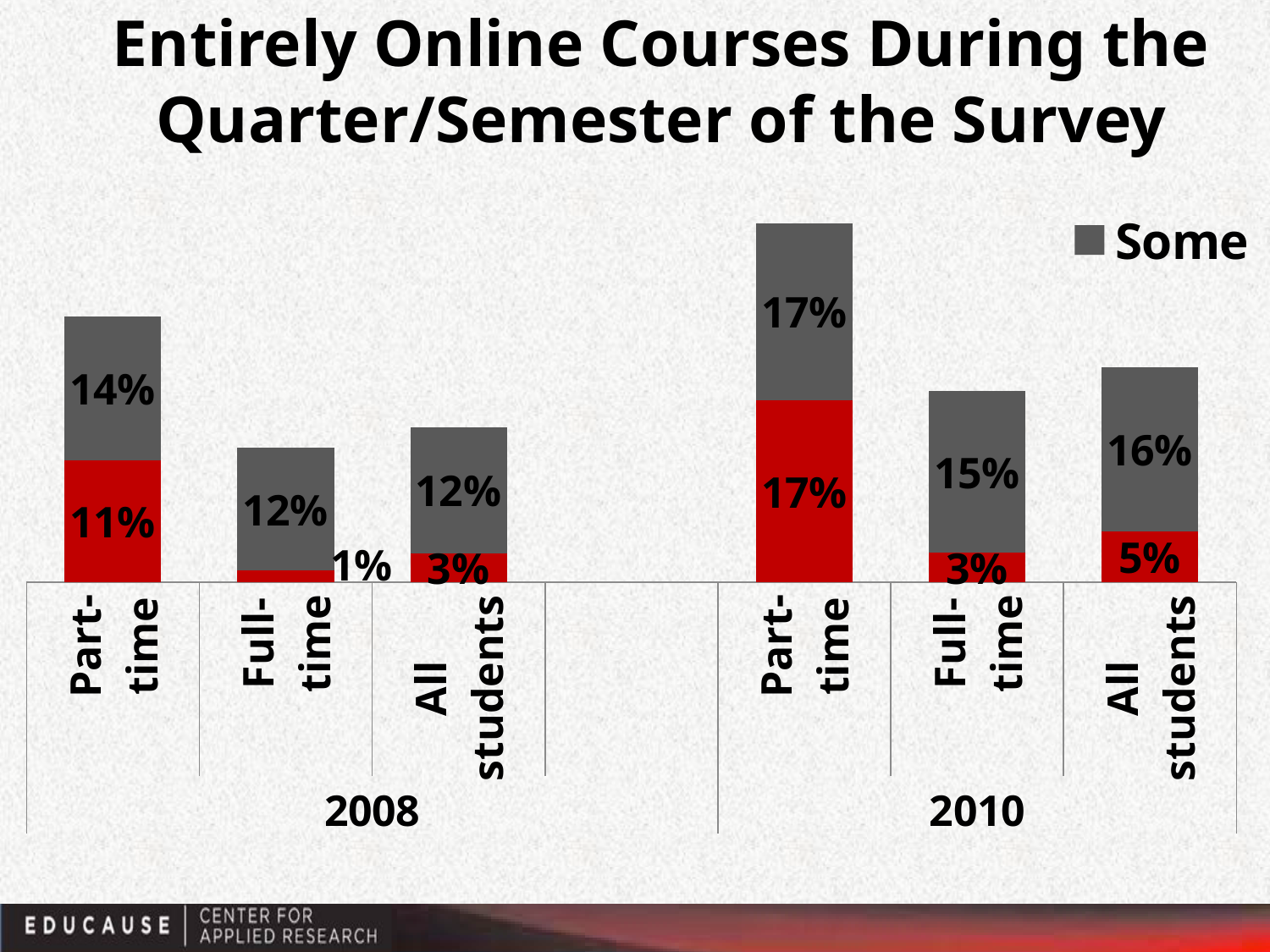
Is the red (lower) segment larger for Part-time students in 2008 or for Part-time students in 2010? 2010 What is the value of the "Some" segment for Full-time students in 2010? 15% What is the value of the "Some" segment for Part-time students in 2008? 14% What is the value of the red (lower) segment for All students in 2008? 3% What is the value of the red (lower) segment for Full-time students in 2008? 1% What is the total height of the stacked bar for All students in 2008? 15% What type of chart is shown on the slide? Stacked bar chart What is the value of the red (lower) segment for Part-time students in 2010? 17% Which stacked bar is the tallest overall? Part-time, 2010 What is the difference between the "Some" values for All students in 2010 and in 2008? 4% What is the total height of the stacked bar for Part-time students in 2010? 34% How many stacked bars are shown in the chart? 6